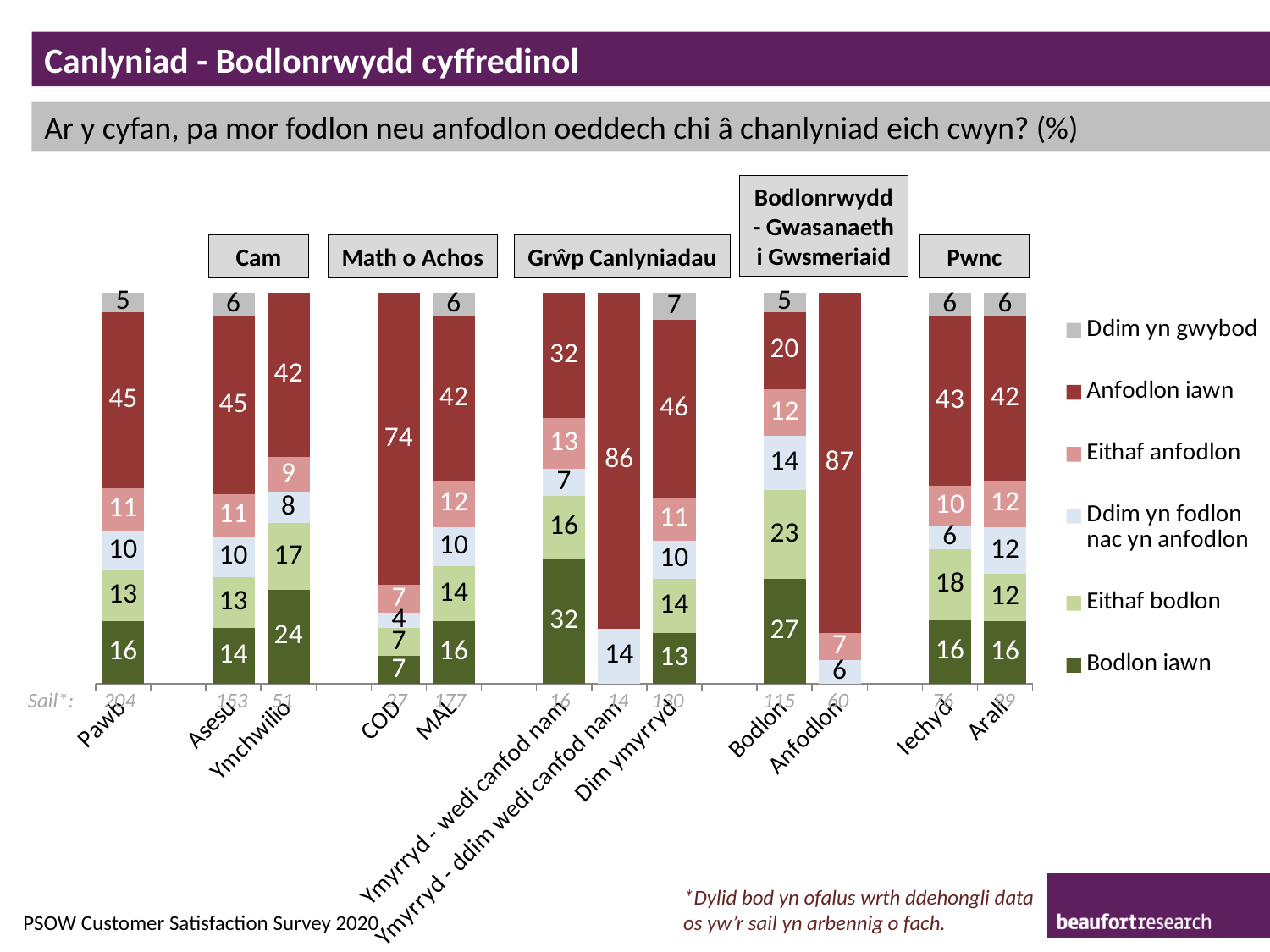
What is the 'Sail' (base) shown for Pawb? 204 Which category has the highest 'Anfodlon iawn' value? Anfodlon What is the 'Anfodlon iawn' value for Pawb? 45 What is the difference between the 'Anfodlon iawn' values for Anfodlon and Bodlon? 67 What kind of chart is shown on the slide? Stacked bar chart How many series does the legend list? 6 How many categories are plotted along the x axis? 12 Which is larger: the 'Eithaf bodlon' value for Bodlon or for Iechyd? Bodlon What is the total of the stacked bar for Pawb? 100 What is the 'Anfodlon iawn' value for COD? 74 What is the 'Bodlon iawn' value for Ymchwilio? 24 Which category has the lowest 'Bodlon iawn' value among those with a printed 'Bodlon iawn' label? COD